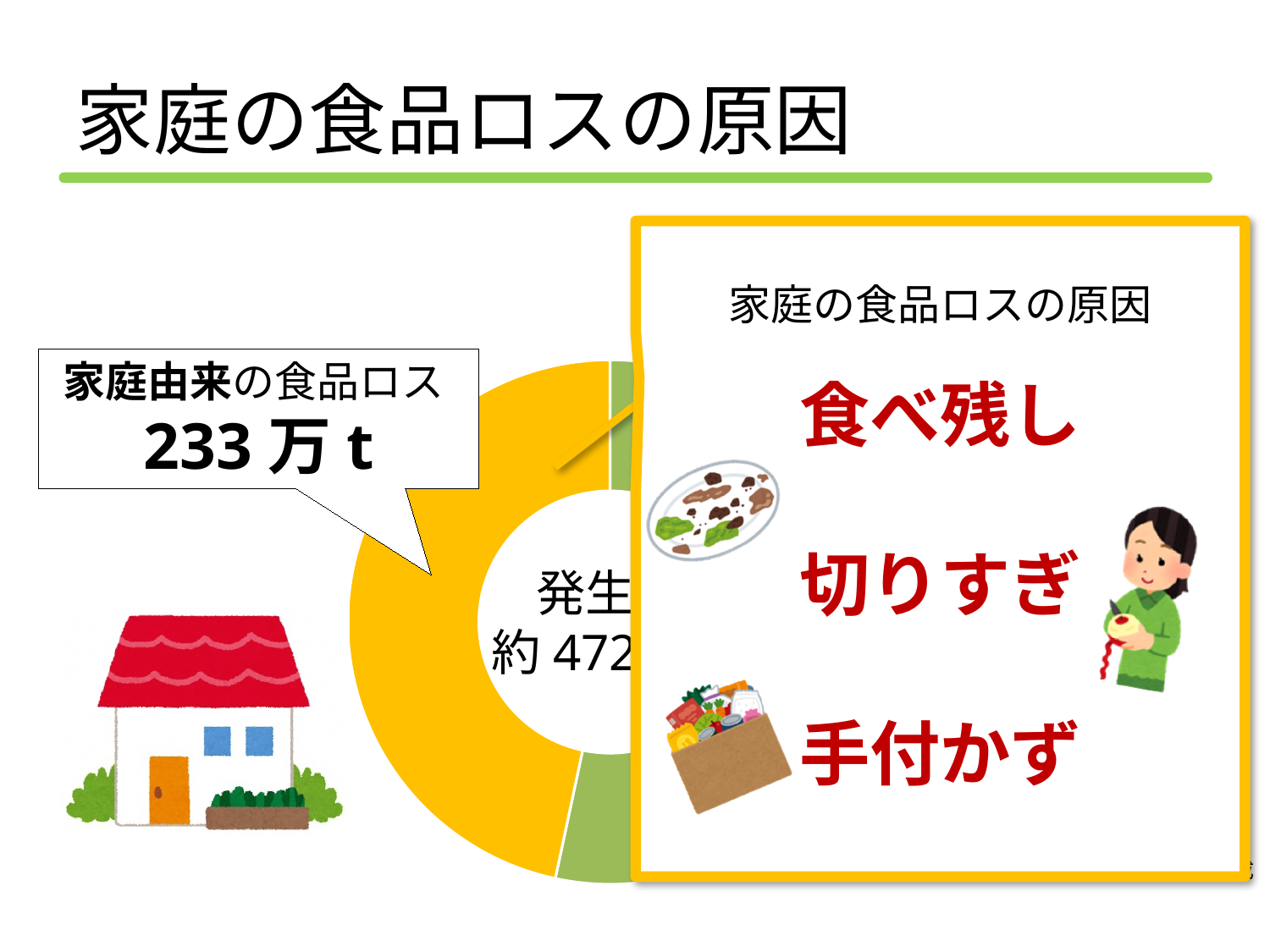
What kind of chart is shown on the slide? pie chart (donut) What value does the callout give for 家庭由来の食品ロス? 233万t Which slice does the callout reading 233万t point to? 家庭由来の食品ロス What colour is the slice labelled 家庭由来の食品ロス? yellow